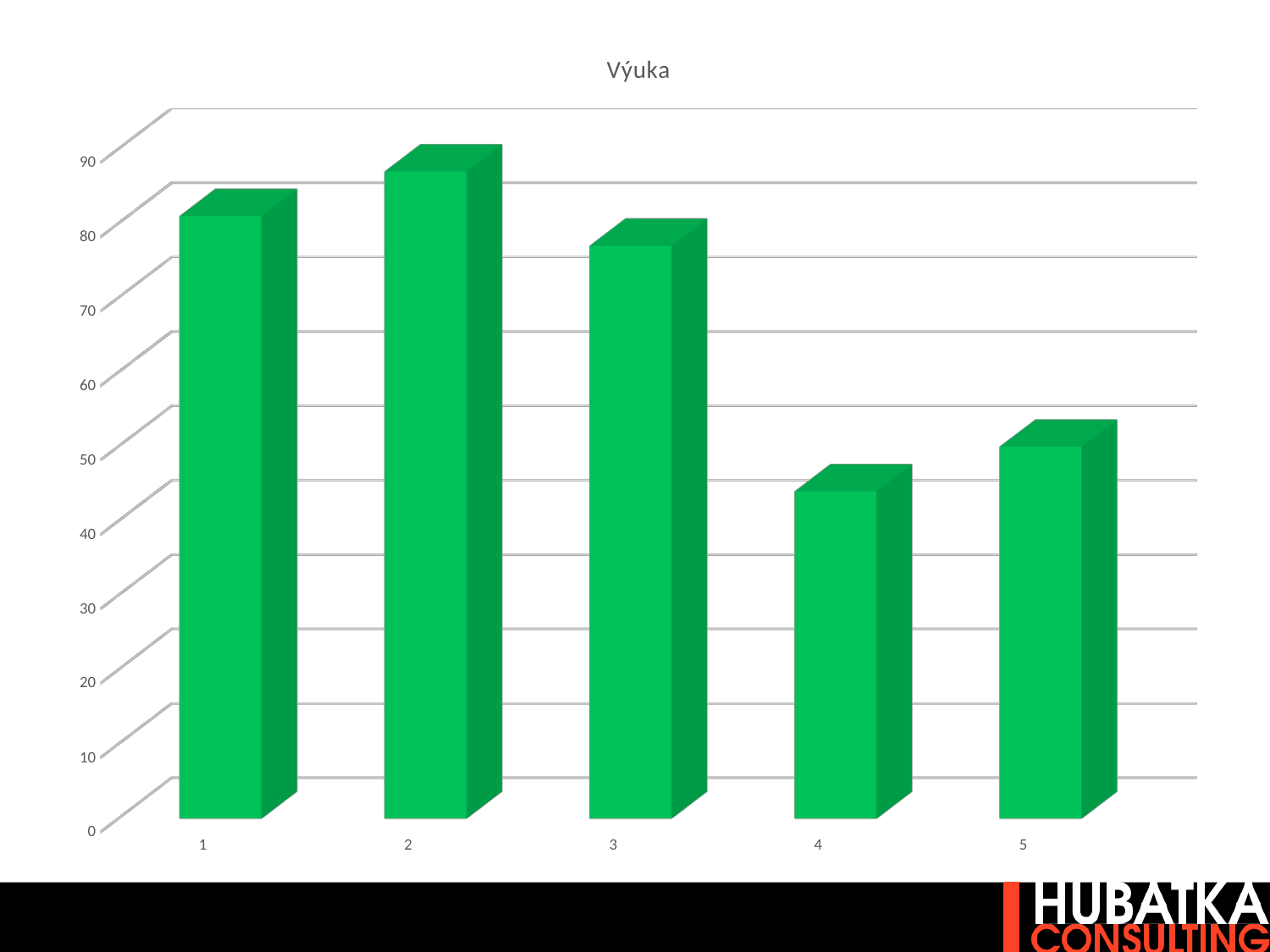
What kind of chart is shown on the slide? bar chart Which is larger, the value for category 4 or category 5? category 5 Is the value for category 2 greater or less than 80? greater Is the value for category 1 greater or less than 70? greater Which is larger, the value for category 1 or category 3? category 1 Which category has the highest bar? 2 How many categories are shown on the x axis? 5 Is the value for category 5 greater or less than 40? greater What is the title of the chart? Výuka Which category has the lowest bar? 4